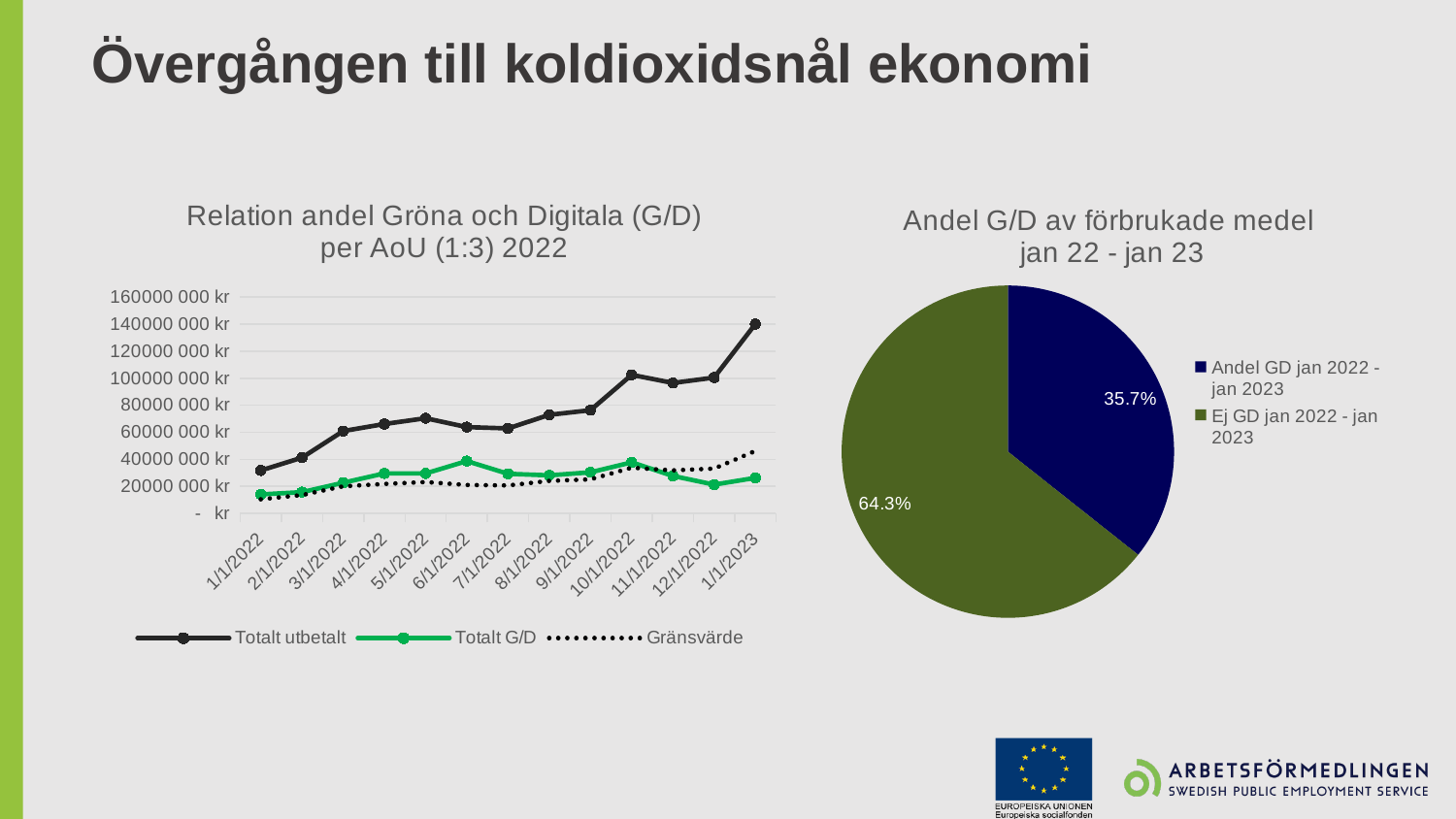
In the left line chart, is the value of 'Totalt utbetalt' at 1/1/2023 greater or less than 120000 000 kr? greater In the pie chart 'Andel G/D av förbrukade medel jan 22 - jan 23', what share is 'Andel GD jan 2022 - jan 2023'? 35.7% What kind of chart is the right chart, 'Andel G/D av förbrukade medel jan 22 - jan 23'? Pie chart In the left line chart, how many dates are shown on the x axis? 13 In the left line chart, is the value of 'Totalt G/D' at 1/1/2022 greater or less than 20000 000 kr? less In the pie chart on the right, what is the difference in percentage points between the 'Ej GD' slice and the 'Andel GD' slice? 28.6 percentage points In the left line chart, at 6/1/2022, which is higher: 'Totalt G/D' or 'Gränsvärde'? Totalt G/D In the pie chart 'Andel G/D av förbrukade medel jan 22 - jan 23', what share is 'Ej GD jan 2022 - jan 2023'? 64.3% In the pie chart on the right, which slice is the largest? Ej GD jan 2022 - jan 2023 In the left line chart, does the 'Totalt utbetalt' series generally rise or fall from 1/1/2022 to 1/1/2023? Rise In the left line chart, how many series does the legend list? 3 What kind of chart is the left chart, 'Relation andel Gröna och Digitala (G/D) per AoU (1:3) 2022'? Line chart